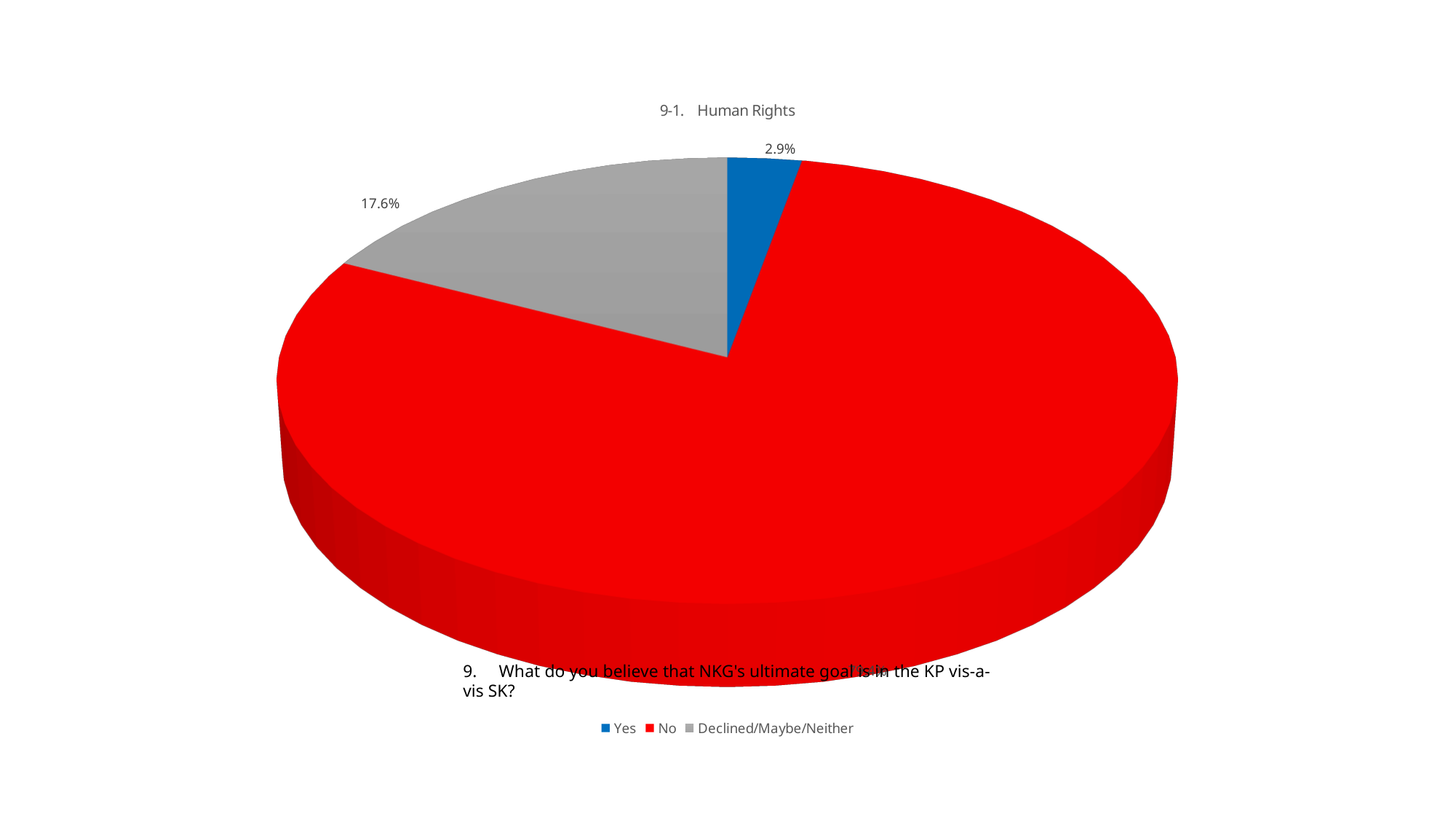
What is the difference in percentage points between the Declined/Maybe/Neither slice and the Yes slice? 14.7% Which slice is larger, No or Declined/Maybe/Neither? No What percentage of the pie is the Declined/Maybe/Neither slice? 17.6% What percentage of the pie is the Yes slice? 2.9% How many entries does the legend list? 3 Which slice is larger, Yes or Declined/Maybe/Neither? Declined/Maybe/Neither How many slices does the pie chart have? 3 What kind of chart is shown on the slide? pie chart Which category has the smallest slice of the pie? Yes Which category has the largest slice of the pie? No What colour is the No slice? red What is the title of the chart? 9-1. Human Rights